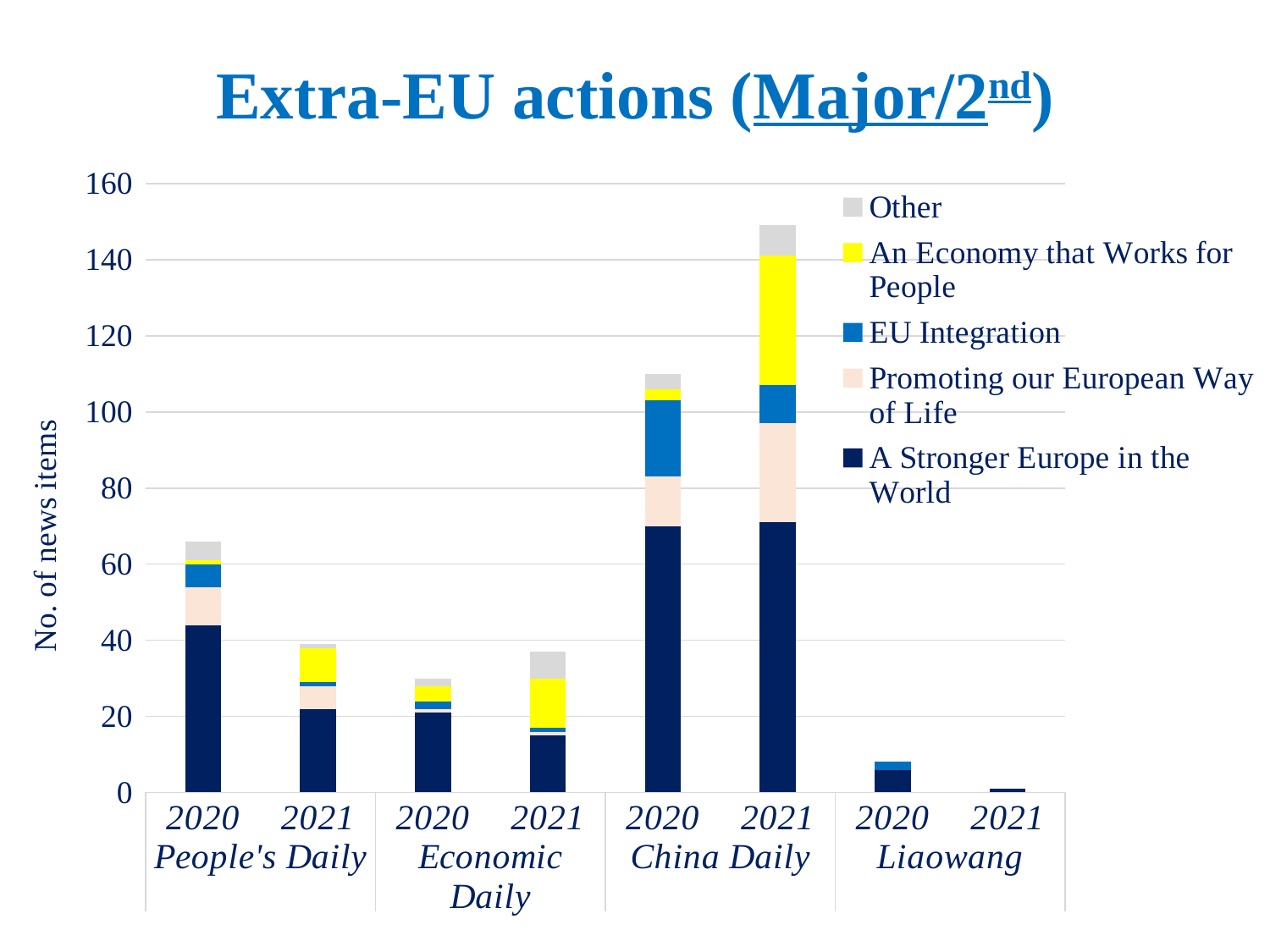
Is the total for China Daily 2021 greater or less than 140? greater Which bar has the highest total number of news items? China Daily 2021 What is the label of the y axis? No. of news items Is the total for Economic Daily 2020 greater or less than 40? less Which is larger, the total for China Daily 2020 or China Daily 2021? China Daily 2021 Is the total for Liaowang 2020 greater or less than 20? less How many series does the legend list? 5 Which bar has the lowest total number of news items? Liaowang 2021 What kind of chart is shown on the slide? Stacked bar chart Which is larger, the total for People's Daily 2020 or People's Daily 2021? People's Daily 2020 How many bars are plotted in the chart? 8